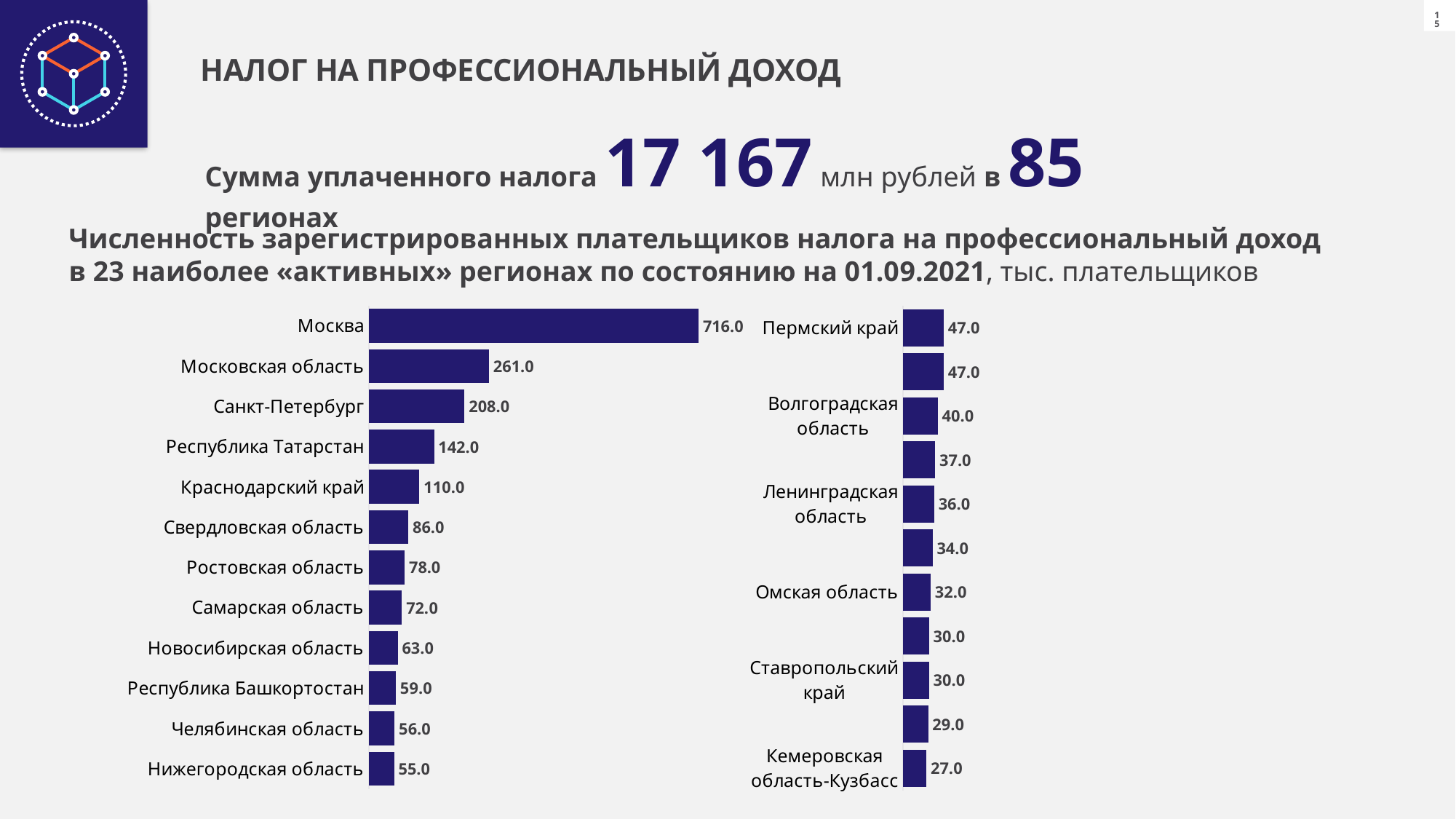
In the right chart, what is the difference between the values for Ленинградская область and Омская область? 4.0 In the left chart, what is the value for Москва? 716.0 How many bars are shown in the left chart? 12 What type of chart is used on this slide? Bar chart In the left chart, which region has the highest value? Москва In the left chart, which region has the lowest value? Нижегородская область In the right chart, which labelled region has the lowest value? Кемеровская область-Кузбасс In the left chart, which is larger: the value for Краснодарский край or for Свердловская область? Краснодарский край In the right chart, what is the value for Омская область? 32.0 In the left chart, what is the difference between the values for Москва and Московская область? 455.0 In the left chart, what is the value for Санкт-Петербург? 208.0 In the right chart, what is the value for Пермский край? 47.0